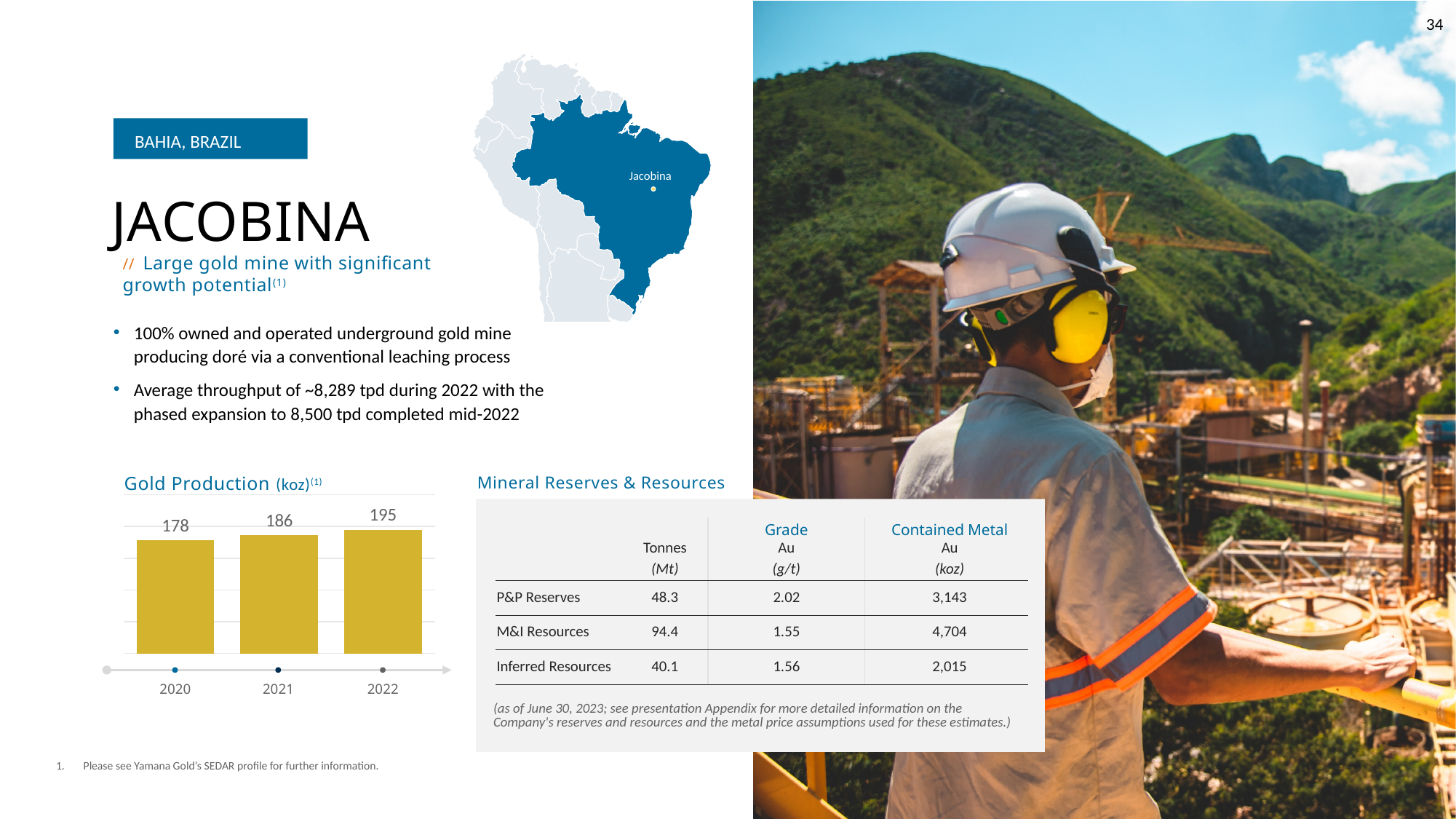
What is the difference in gold production between 2022 and 2020 in the Gold Production chart? 17 Does gold production rise or fall from 2020 to 2022 in the Gold Production chart? rise Which year has the highest gold production in the Gold Production chart? 2022 What is the difference in gold production between 2021 and 2020 in the Gold Production chart? 8 What is the gold production value for 2021 in the Gold Production chart? 186 In the Gold Production chart, is the value for 2021 larger or smaller than the value for 2022? smaller What kind of chart is the Gold Production chart? bar chart What is the gold production value for 2022 in the Gold Production chart? 195 What unit is gold production measured in, according to the Gold Production chart title? koz What is the gold production value for 2020 in the Gold Production chart? 178 Which year has the lowest gold production in the Gold Production chart? 2020 How many years are shown in the Gold Production chart? 3